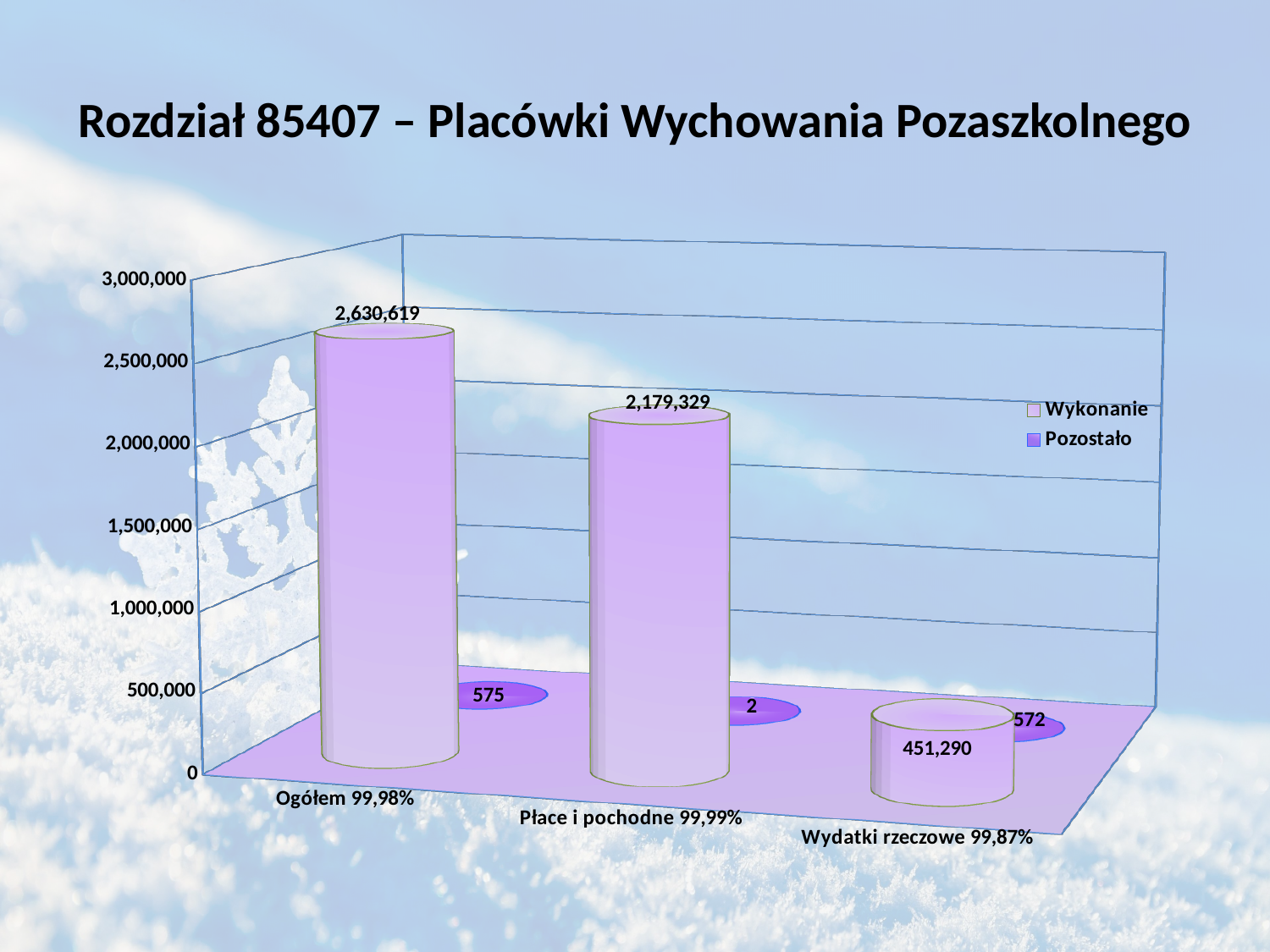
What is the Wykonanie value for Płace i pochodne 99,99%? 2,179,329 What is the Pozostało value for Płace i pochodne 99,99%? 2 Which category has the highest Wykonanie value? Ogółem 99,98% How many categories are shown on the x axis? 3 Which category has the lowest Wykonanie value? Wydatki rzeczowe 99,87% What is the Pozostało value for Ogółem 99,98%? 575 Which is larger, the Pozostało value for Ogółem 99,98% or for Wydatki rzeczowe 99,87%? Ogółem 99,98% What is the Wykonanie value for Ogółem 99,98%? 2,630,619 How many series does the legend list? 2 What kind of chart is shown on the slide? Bar chart What is the Wykonanie value for Wydatki rzeczowe 99,87%? 451,290 What is the difference between the Wykonanie values for Ogółem 99,98% and Płace i pochodne 99,99%? 451,290